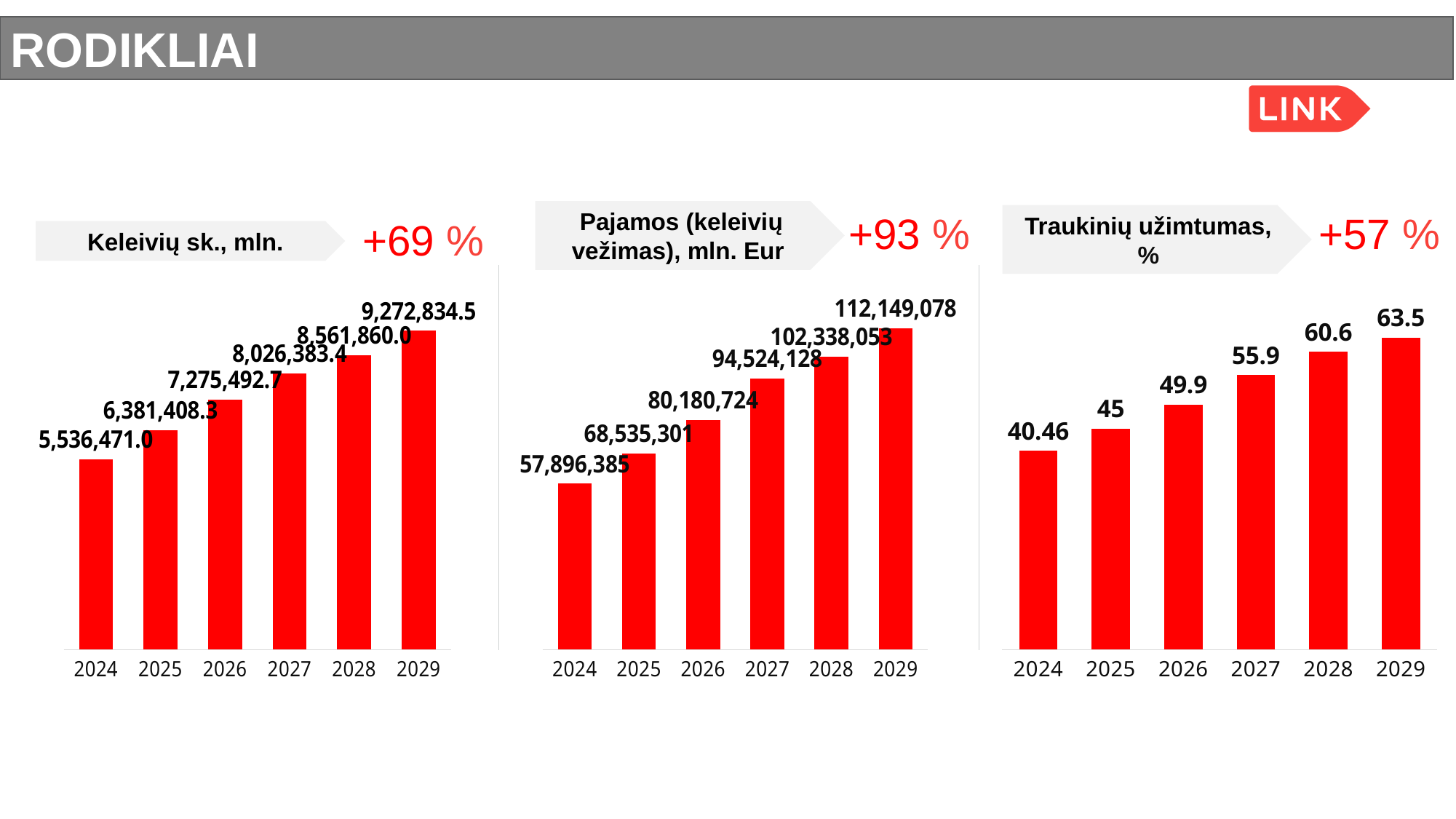
What kind of chart is the 'Pajamos (keleivių vežimas), mln. Eur' chart? Bar chart How many years are shown on the x axis of the 'Traukinių užimtumas, %' chart? 6 In the 'Keleivių sk., mln.' chart, what is the value for 2024? 5,536,471.0 In the 'Keleivių sk., mln.' chart, do the values rise or fall from 2024 to 2029? Rise In the 'Keleivių sk., mln.' chart, what is the value for 2027? 8,026,383.4 In the 'Pajamos (keleivių vežimas), mln. Eur' chart, what is the value for 2026? 80,180,724 In the 'Traukinių užimtumas, %' chart, what is the difference between the 2029 and 2024 values? 23.04 In the 'Traukinių užimtumas, %' chart, what is the difference between the 2028 and 2027 values? 4.7 In the 'Keleivių sk., mln.' chart, which is larger, the value for 2025 or the value for 2026? 2026 In the 'Pajamos (keleivių vežimas), mln. Eur' chart, what is the difference between the 2029 and 2024 values? 54,252,693 In the 'Traukinių užimtumas, %' chart, which year has the lowest value? 2024 In the 'Pajamos (keleivių vežimas), mln. Eur' chart, which year has the highest value? 2029